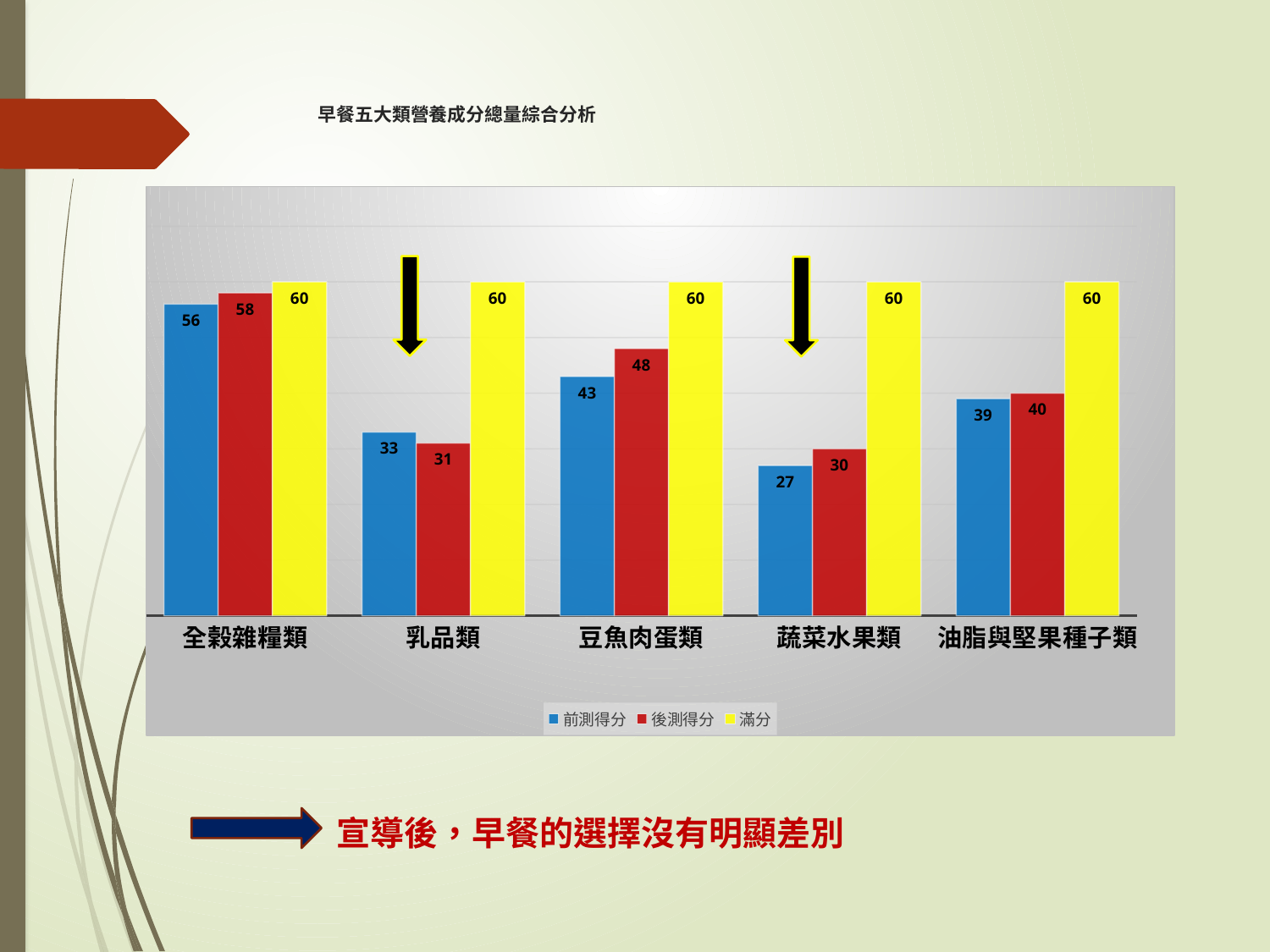
How many series does the legend list? 3 What is the 前測得分 value for 全穀雜糧類? 56 What is the 後測得分 value for 豆魚肉蛋類? 48 How many categories are shown on the x axis? 5 Which is larger for 乳品類, the 前測得分 or the 後測得分? 前測得分 What is the 滿分 value for each category? 60 Which category has the lowest 前測得分? 蔬菜水果類 What is the difference between the 後測得分 and 前測得分 for 豆魚肉蛋類? 5 What is the 後測得分 value for 乳品類? 31 What kind of chart is shown on the slide? bar chart What is the 前測得分 value for 蔬菜水果類? 27 Which category has the highest 後測得分? 全穀雜糧類